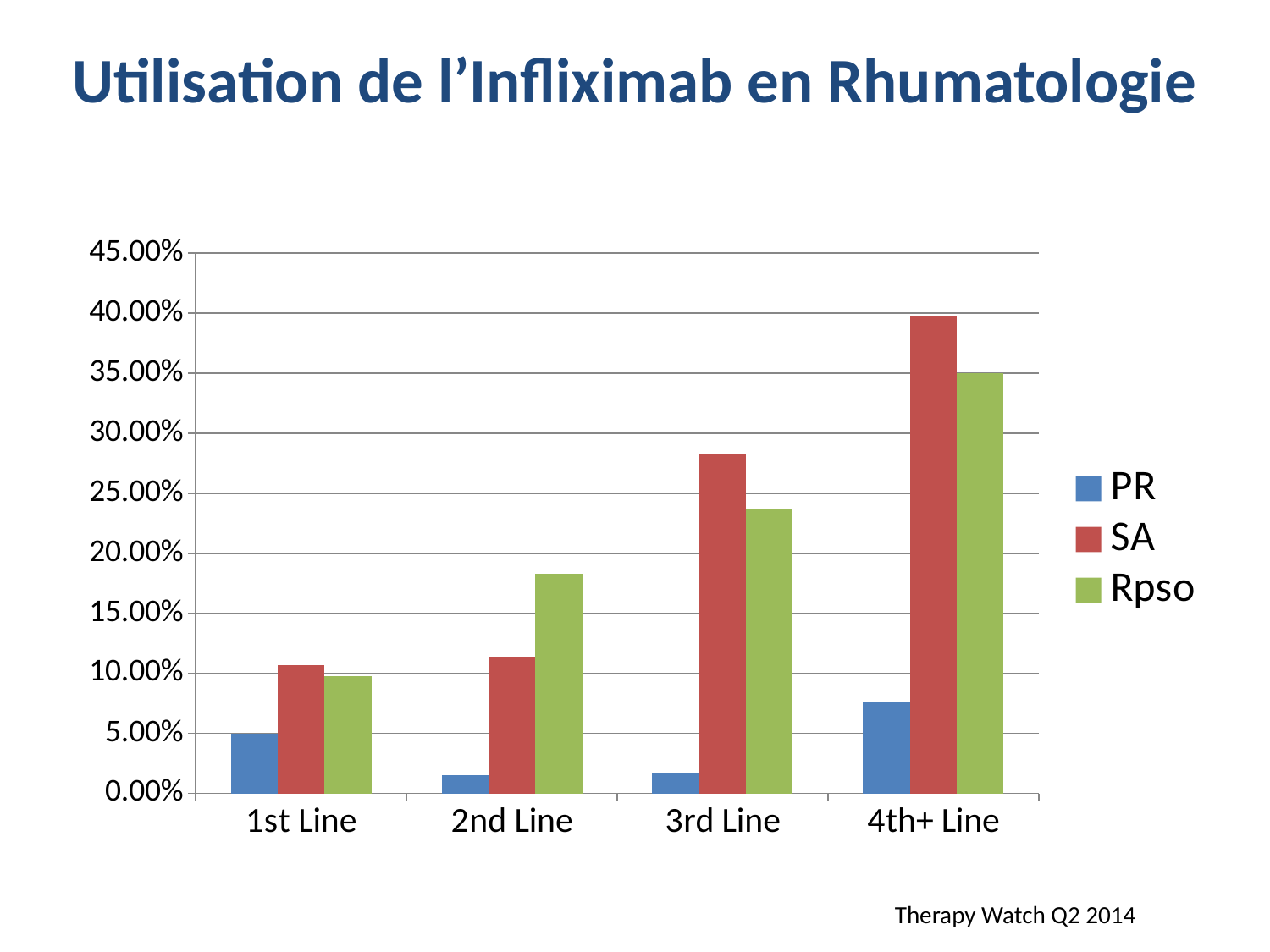
Is the Rpso value for 2nd Line greater or less than 20.00%? less What kind of chart is shown on the slide? bar chart How many treatment line categories are shown on the x axis? 4 How many series does the legend list? 3 Is the SA value for 4th+ Line greater or less than 35.00%? greater Is the PR value for 4th+ Line greater or less than 5.00%? greater Do the SA values rise or fall from 1st Line to 4th+ Line? rise In the 2nd Line category, which is larger, SA or Rpso? Rpso What source is cited at the bottom of the slide? Therapy Watch Q2 2014 For which treatment line is the SA value highest? 4th+ Line In the 3rd Line category, which is larger, SA or Rpso? SA For which treatment line is the Rpso value lowest? 1st Line